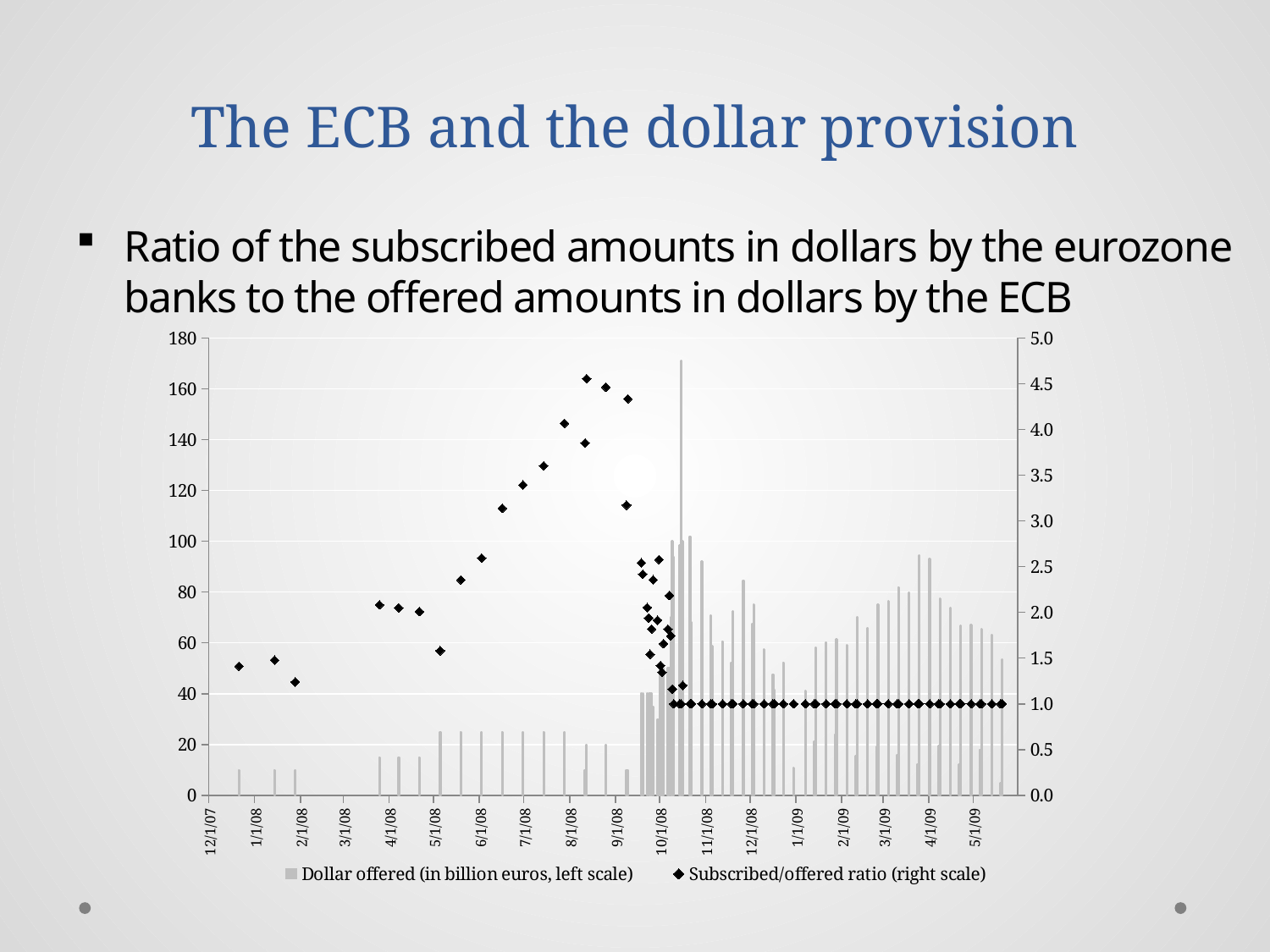
Does the tallest Dollar offered bar occur before or after 9/1/08? after Is the highest Subscribed/offered ratio point greater or less than 4.0? greater What kind of chart is shown on the slide? A bar chart combined with a scatter (diamond marker) series What is the highest tick value on the right axis? 5.0 From late 2008 onward, are the Subscribed/offered ratio points greater or less than 1.5? less What is the highest tick value on the left axis? 180 Is the tallest Dollar offered bar greater or less than 160? greater Does the Subscribed/offered ratio rise or fall between 5/1/08 and 8/1/08? rise How many series does the legend list? 2 Which series is plotted against the right scale? Subscribed/offered ratio What are the two legend entries of the chart? Dollar offered (in billion euros, left scale) and Subscribed/offered ratio (right scale)